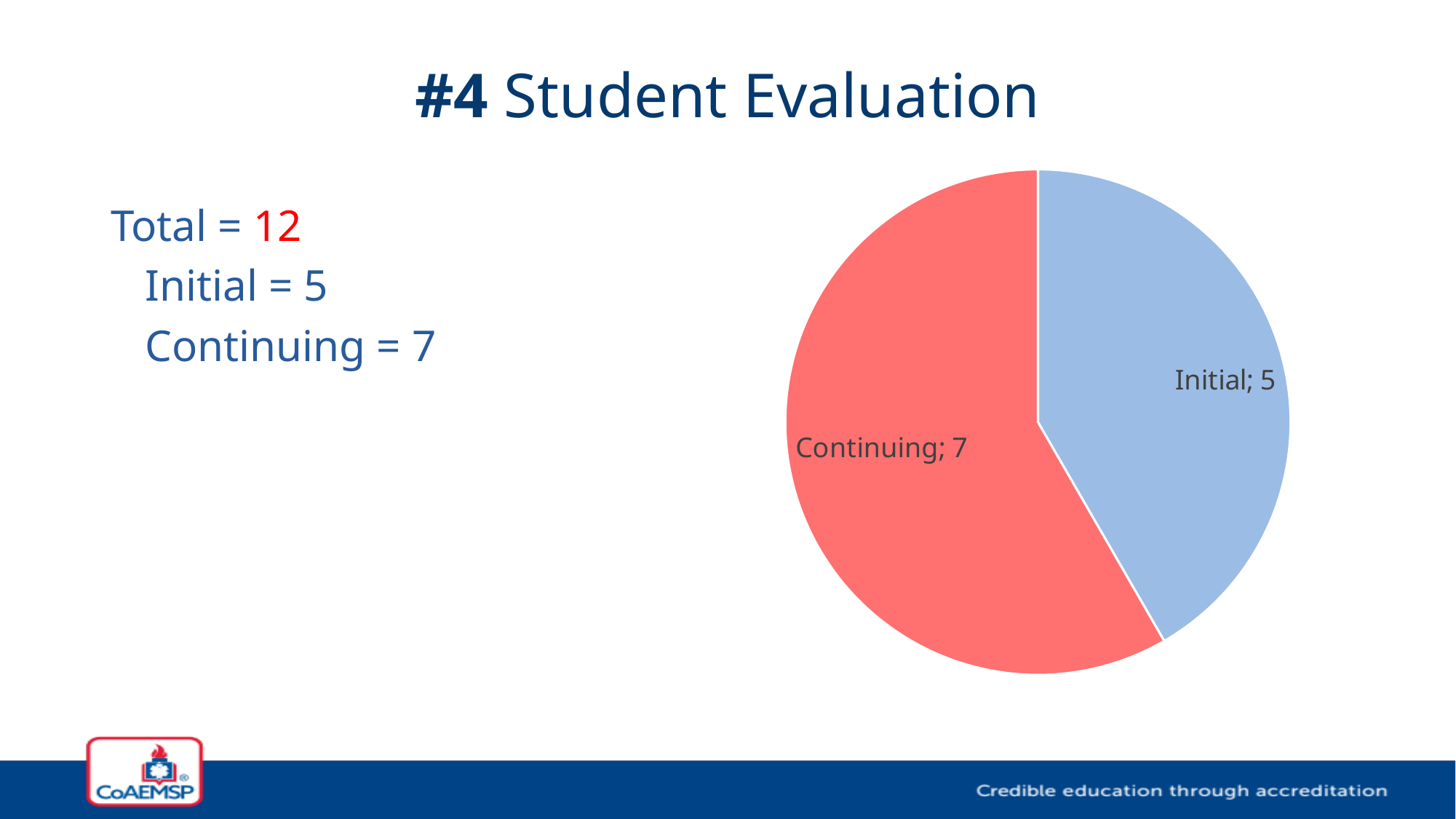
What kind of chart is shown on the slide? pie chart What is the total of all slices in the pie chart? 12 How many slices does the pie chart have? 2 What is the difference between the Continuing and Initial values? 2 What colour is the Initial slice? light blue What is the value for Initial in the pie chart? 5 Which slice of the pie chart is the smallest? Initial What share of the pie does the Continuing slice represent? 7/12 Which slice of the pie chart is the largest? Continuing What is the value for Continuing in the pie chart? 7 Which is larger, Initial or Continuing? Continuing What colour is the Continuing slice? red